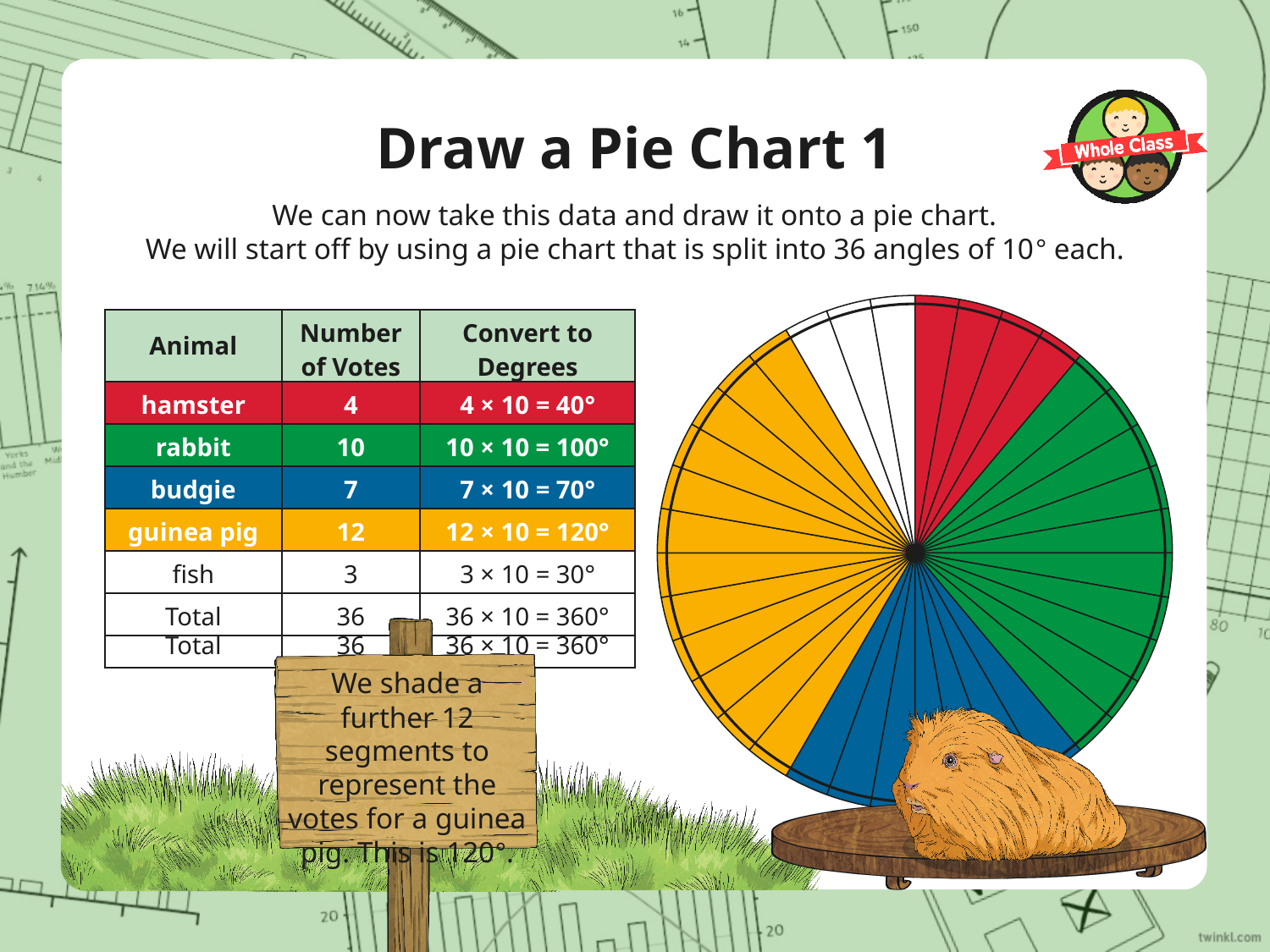
What is the total number of votes? 36 How many animals are listed in the table? 5 Which animal received the most votes? guinea pig How many degrees does the rabbit segment of the pie chart represent? 100° Which animal received the fewest votes? fish What kind of chart is shown on the slide? pie chart How many votes did guinea pig receive? 12 How many more votes did rabbit receive than budgie? 3 How many equal angles is the pie chart split into? 36 Which animal's segments are still unshaded (white) on the pie chart? fish What angle of the pie chart does the guinea pig take up? 120° Which received more votes, hamster or budgie? budgie